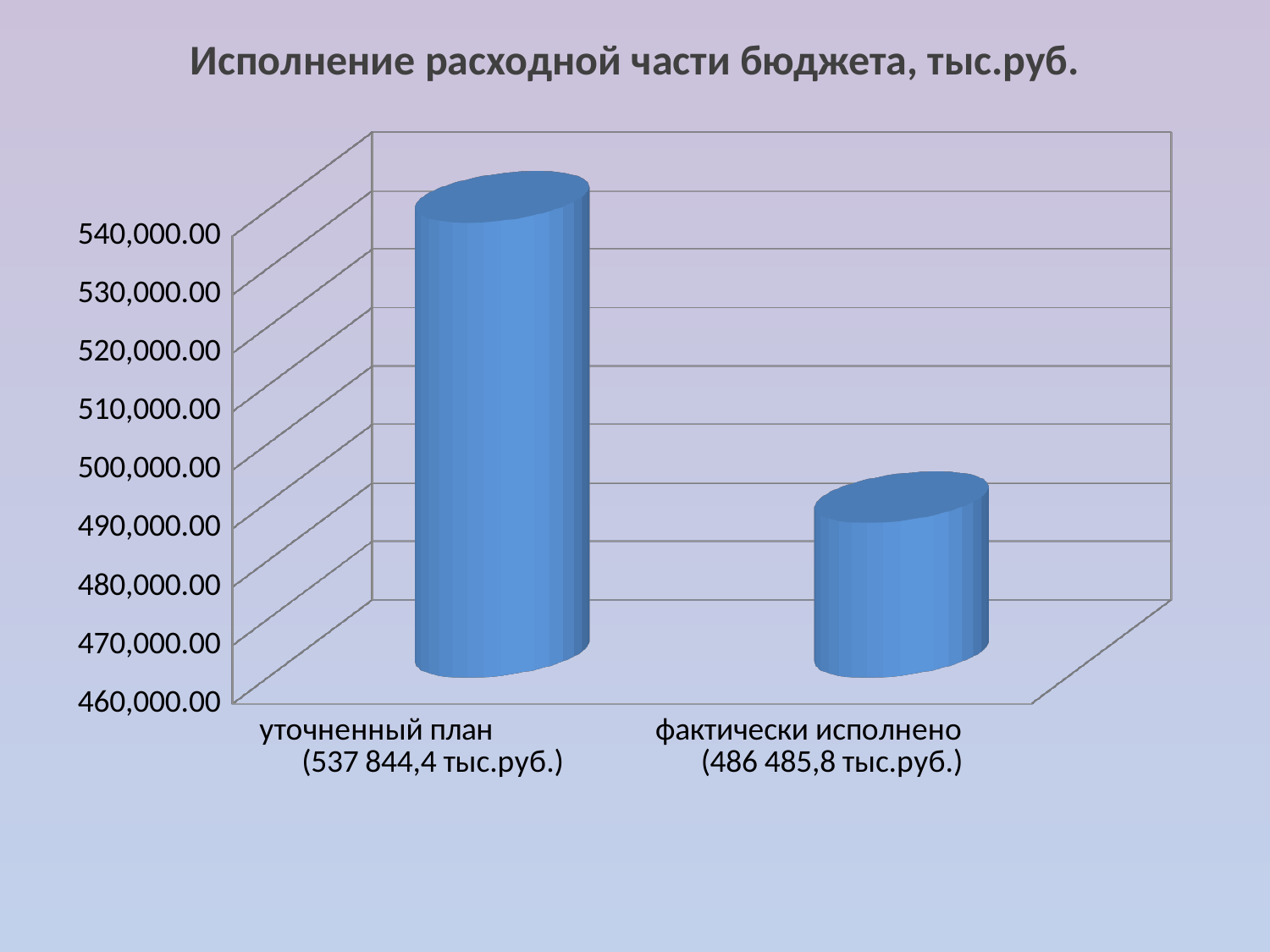
How many categories are shown in the chart? 2 Which is larger, уточненный план or фактически исполнено? уточненный план Which category has the lowest value? фактически исполнено What kind of chart is shown on the slide? bar chart What is the value for уточненный план? 537 844,4 тыс.руб. What is the value for фактически исполнено? 486 485,8 тыс.руб. Is the value for фактически исполнено greater or less than 500,000.00? less Is the value for уточненный план greater or less than 530,000.00? greater What is the title of the chart? Исполнение расходной части бюджета, тыс.руб. What is the difference between уточненный план and фактически исполнено? 51 358,6 тыс.руб. Do the values rise or fall from left to right along the x axis? fall Which category has the highest value? уточненный план